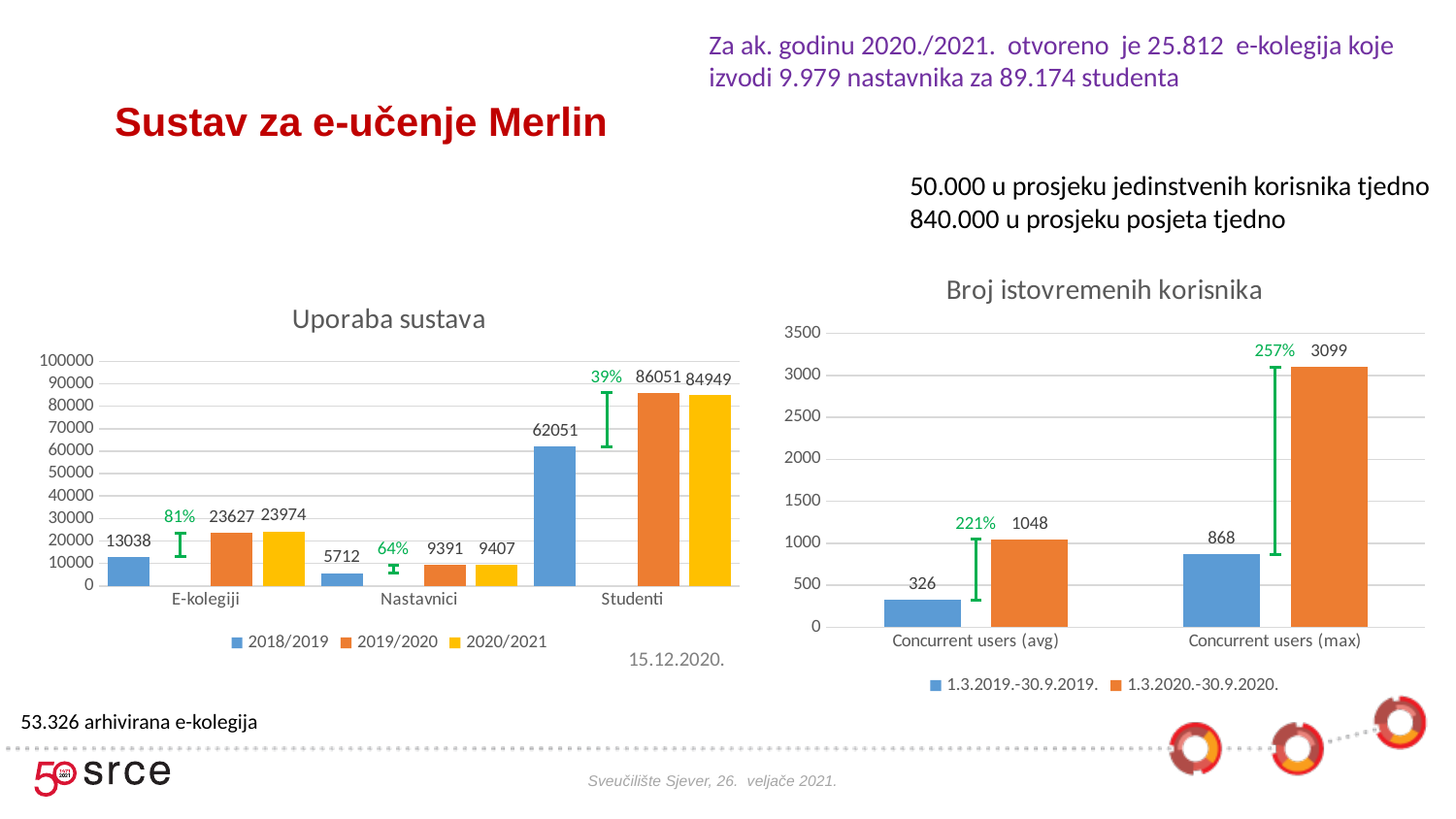
In the 'Uporaba sustava' chart, which category has the highest value in 2020/2021? Studenti In the 'Uporaba sustava' chart, what is the value for E-kolegiji in 2020/2021? 23974 In the 'Uporaba sustava' chart, what is the value for Nastavnici in 2018/2019? 5712 In the 'Uporaba sustava' chart, what is the difference between the 2019/2020 and 2018/2019 values for E-kolegiji? 10589 What type of chart is 'Broj istovremenih korisnika'? Bar chart In the 'Broj istovremenih korisnika' chart, what is the difference between the two periods for Concurrent users (avg)? 722 In the 'Uporaba sustava' chart, how many categories are shown on the x axis? 3 In the 'Uporaba sustava' chart, how many series does the legend list? 3 In the 'Broj istovremenih korisnika' chart, what is the value for Concurrent users (max) in the 1.3.2020.-30.9.2020. period? 3099 In the 'Broj istovremenih korisnika' chart, which is larger: Concurrent users (max) for 1.3.2019.-30.9.2019. or Concurrent users (avg) for 1.3.2020.-30.9.2020.? Concurrent users (avg) for 1.3.2020.-30.9.2020. In the 'Broj istovremenih korisnika' chart, what is the value for Concurrent users (avg) in the 1.3.2019.-30.9.2019. period? 326 In the 'Uporaba sustava' chart, what is the value for Studenti in 2019/2020? 86051